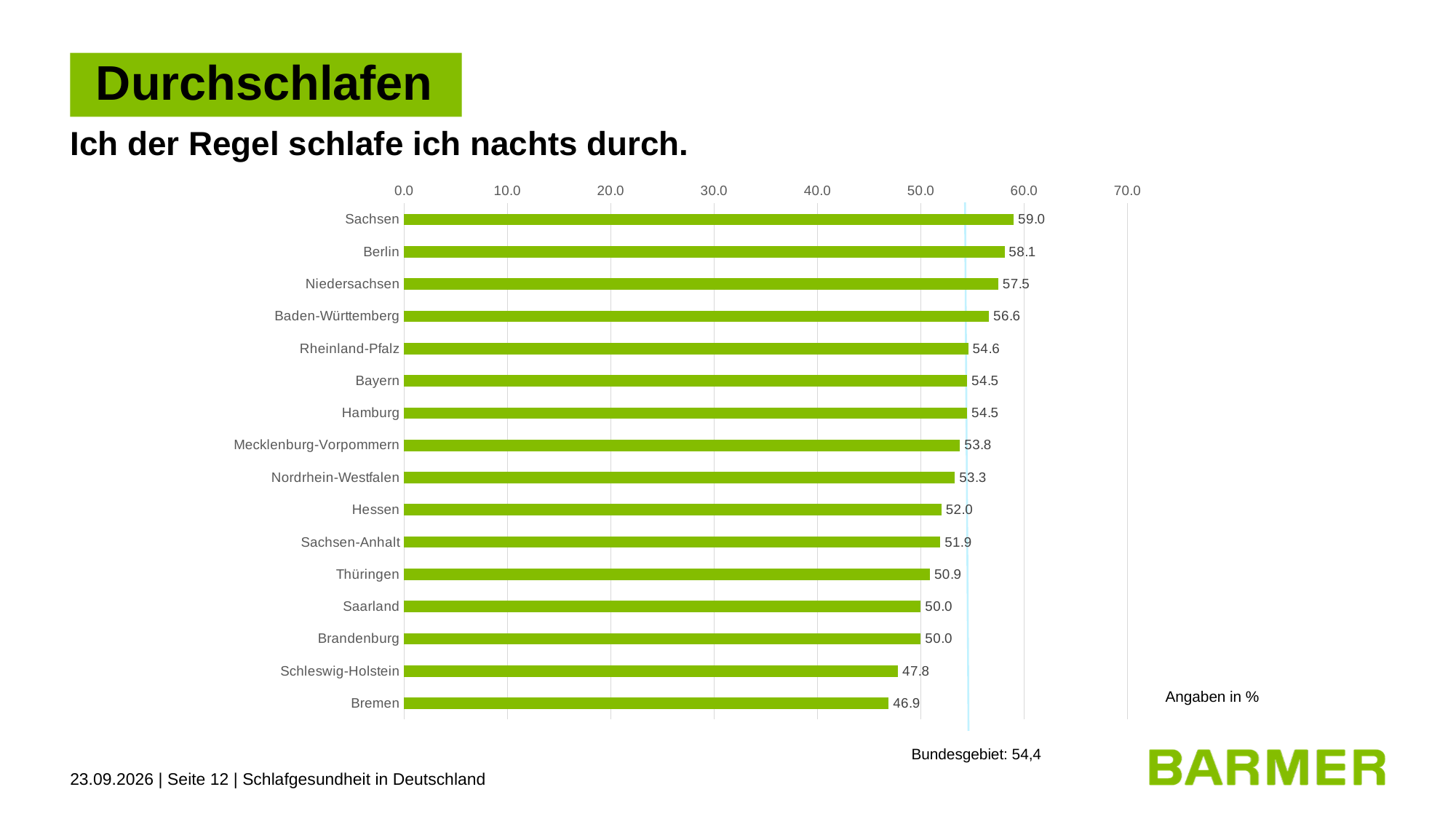
Which has a larger value, Niedersachsen or Thüringen? Niedersachsen What is the value for Sachsen? 59.0 What is the value for Schleswig-Holstein? 47.8 What is the value for Nordrhein-Westfalen? 53.3 Which federal state has the lowest value? Bremen What is the difference between the values for Berlin and Hessen? 6.1 What kind of chart is shown on the slide? Bar chart Which federal state has the highest value? Sachsen How many federal states are shown in the chart? 16 Is the value for Baden-Württemberg greater or less than 50.0? greater What value is given for Bundesgebiet below the chart? 54,4 What is the difference between the values for Sachsen and Bremen? 12.1